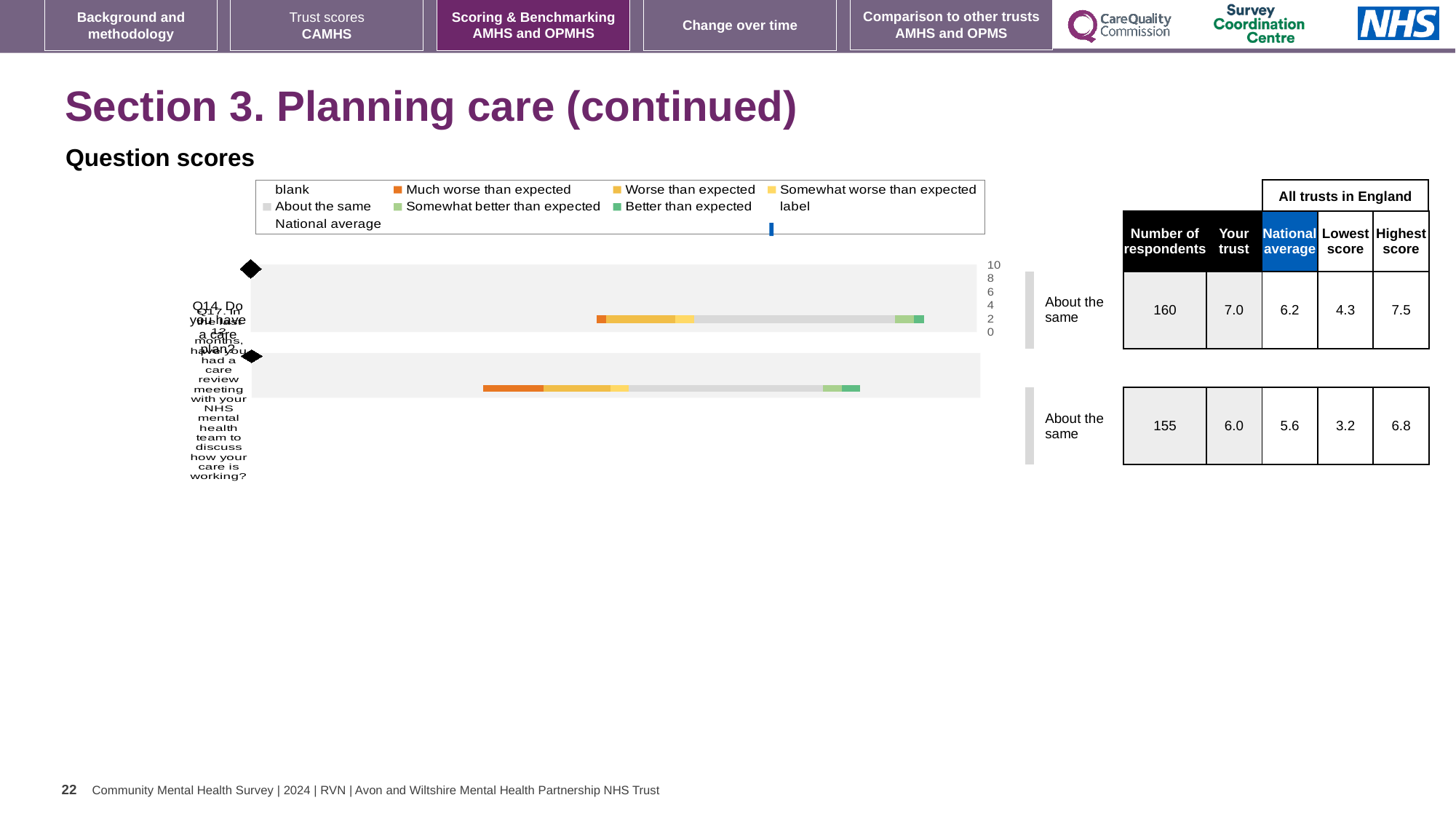
Which question's bar starts further to the left in the chart, Q14 or Q17? Q17 According to the table beside the chart, how is the trust's score for Q14 categorised relative to expectation? About the same In the table beside the chart, what is the 'Your trust' score for Q14 (Do you have a care plan?)? 7.0 How many questions (categories) are plotted in the chart? 2 In the table beside the chart, how many respondents answered Q14? 160 Which colour represents 'Much worse than expected' in the chart legend? Orange In the table beside the chart, what is the national average for Q17 (care review meeting)? 5.6 In the table beside the chart, what is the difference between the highest score and the lowest score for Q17? 3.6 Which question's bar extends further to the right in the chart, Q14 or Q17? Q14 How many entries does the chart legend list? 9 Which colour represents 'About the same' in the chart legend? Grey What kind of chart is shown on the slide? Bar chart